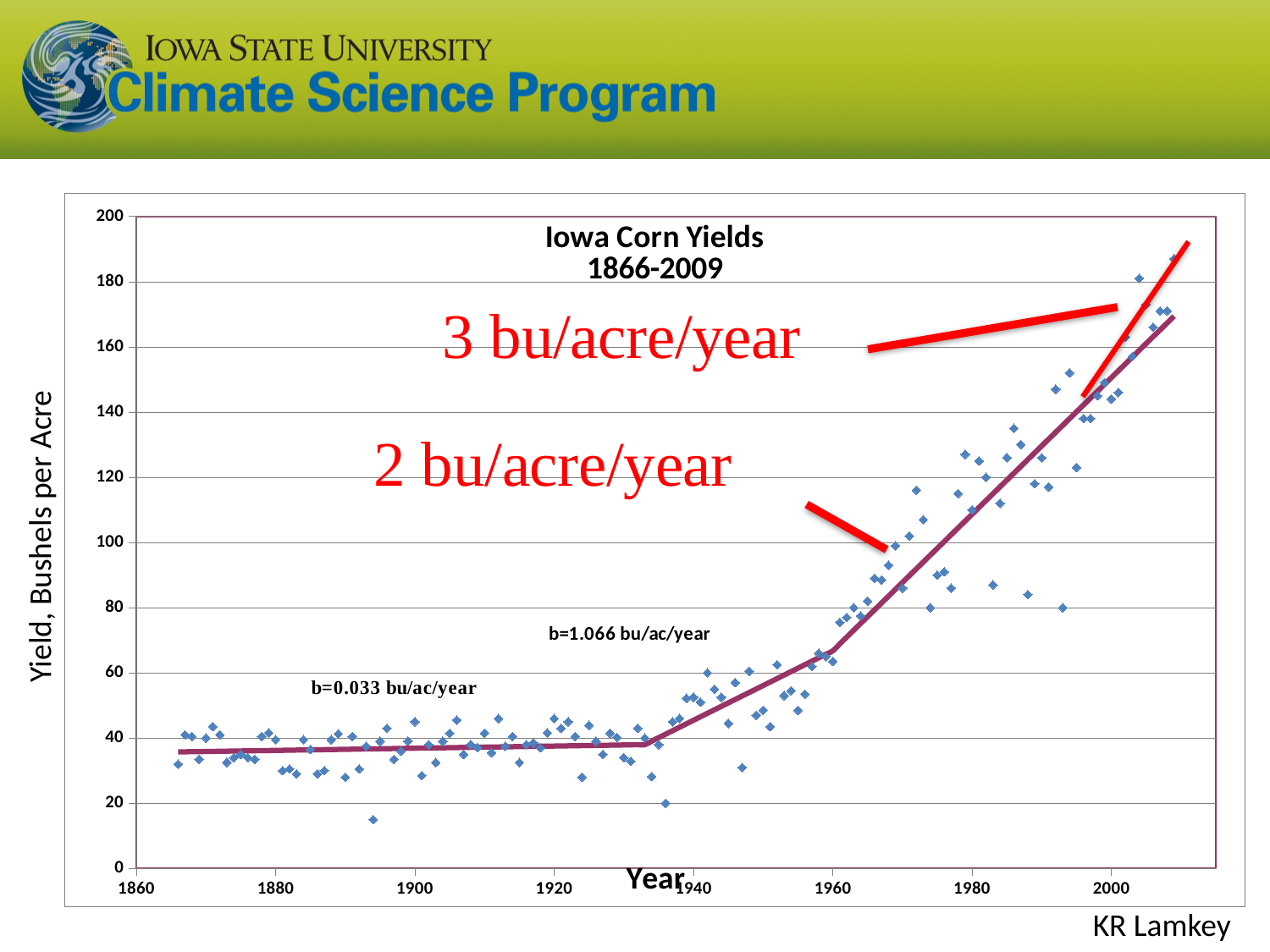
Which period has higher yields: around 1880 or around 2000? around 2000 What kind of chart is shown on the slide? scatter chart What rate is written in red for the segment of the trend starting around 1960? 2 bu/acre/year What rate is written in red for the steepest, most recent segment of the trend? 3 bu/acre/year Is the yield for the highest point near 2005 greater or less than 160 bushels per acre? greater What slope (b) is printed for the middle segment of the trend line? b=1.066 bu/ac/year What is the label of the vertical axis? Yield, Bushels per Acre What is the title of the chart? Iowa Corn Yields 1866-2009 What slope (b) is printed for the early, flat segment of the trend line? b=0.033 bu/ac/year What is the maximum value shown on the vertical axis? 200 Are the yields around 1900 greater or less than 60 bushels per acre? less Do corn yields generally rise or fall from 1940 to 2009? rise